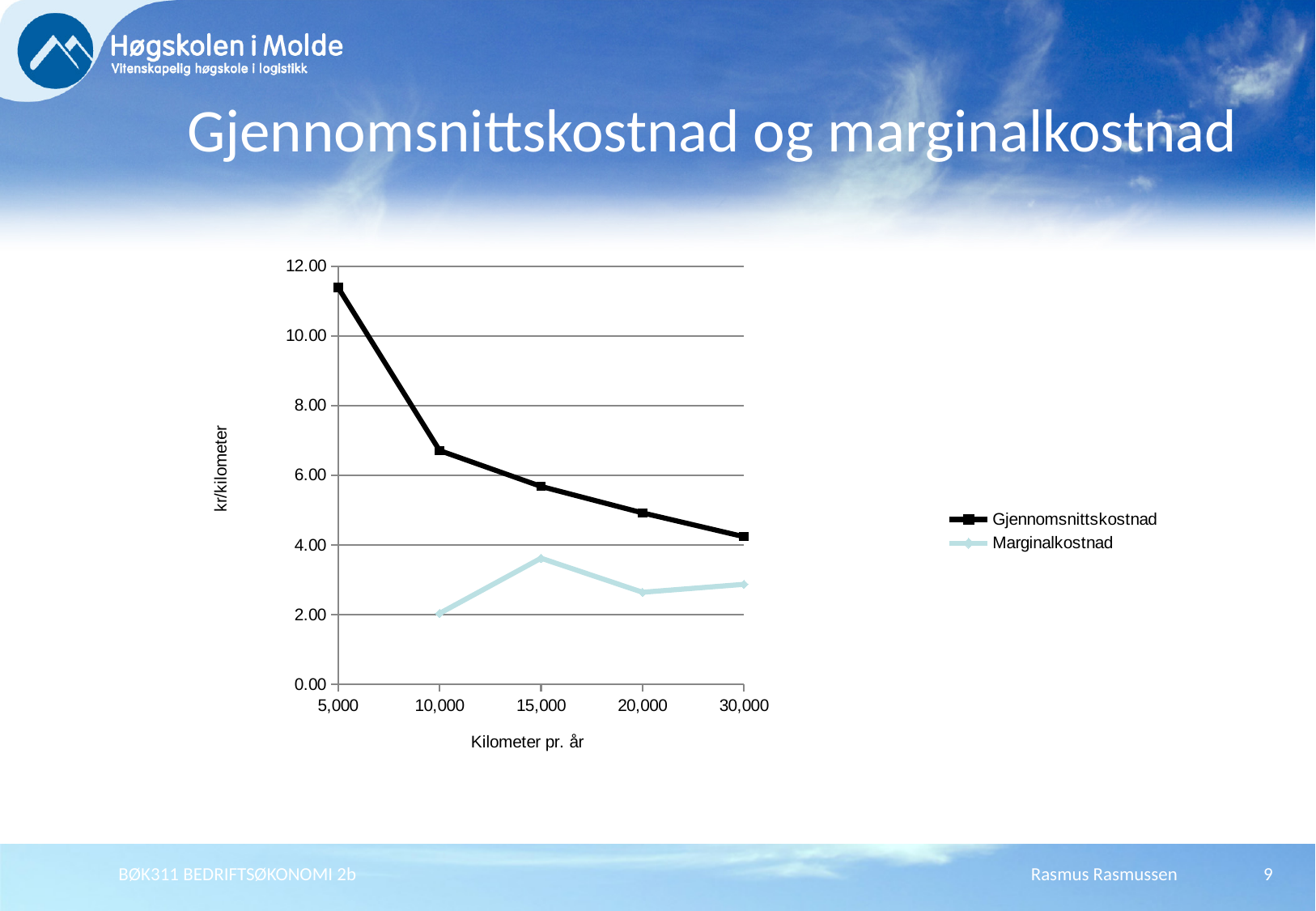
Does the Gjennomsnittskostnad series rise or fall as Kilometer pr. år increases? fall At which Kilometer pr. år value is Marginalkostnad highest? 15,000 At which Kilometer pr. år value is Gjennomsnittskostnad highest? 5,000 At 15,000 kilometer, which series has the larger value, Gjennomsnittskostnad or Marginalkostnad? Gjennomsnittskostnad At which Kilometer pr. år value is Gjennomsnittskostnad lowest? 30,000 What is the label on the vertical axis of the chart? kr/kilometer How many categories are shown on the x axis? 5 What kind of chart is shown on the slide? line chart Is the Gjennomsnittskostnad value at 10,000 kilometer greater or less than 6.00? greater Is the Marginalkostnad value at 15,000 kilometer greater or less than 4.00? less Is the Gjennomsnittskostnad value at 5,000 kilometer greater or less than 10.00? greater How many series does the legend list? 2